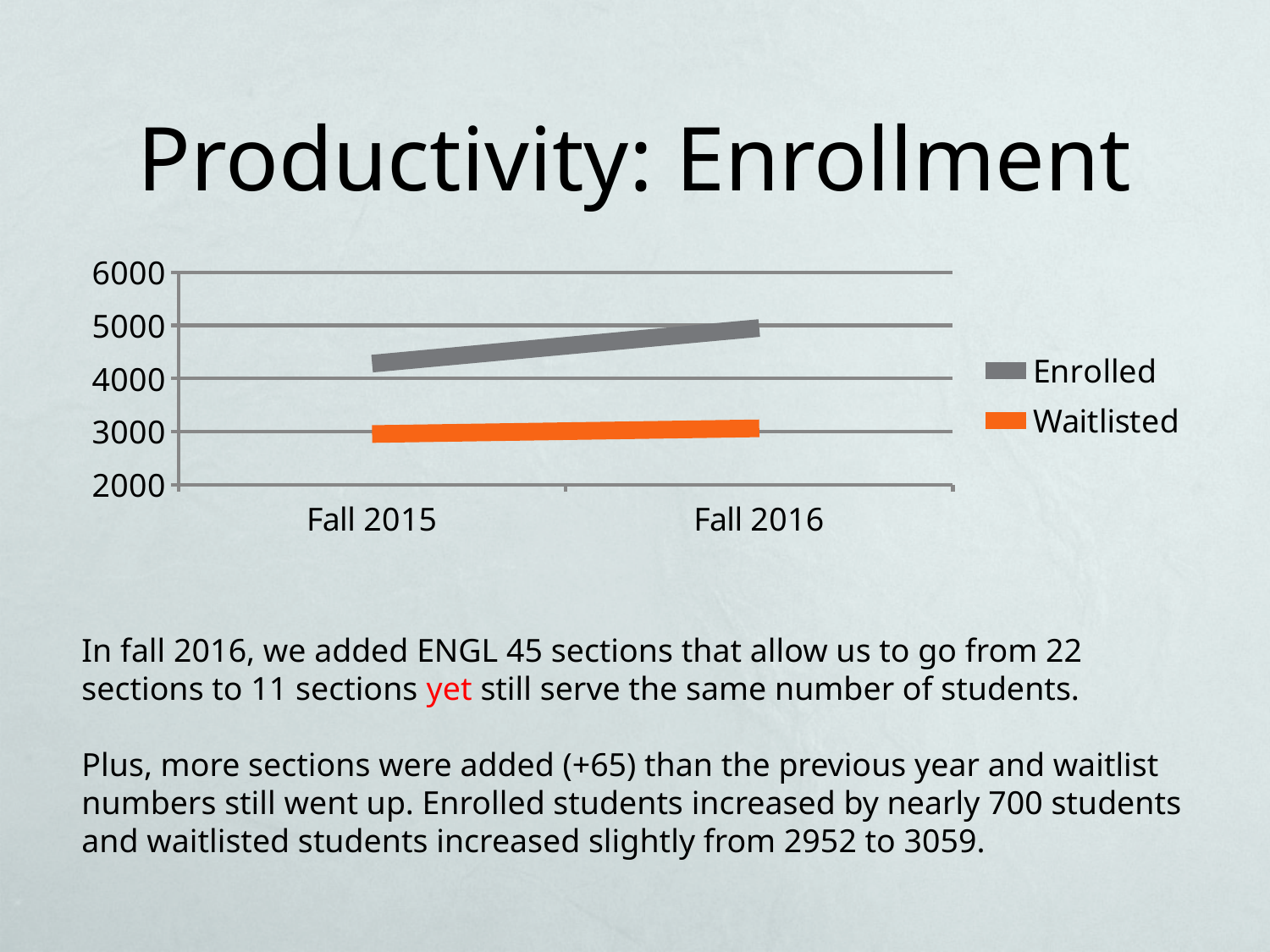
Is the Waitlisted value for Fall 2016 greater or less than 4000? less Is the Enrolled value for Fall 2015 greater or less than 4000? greater Does the Waitlisted line rise or fall from Fall 2015 to Fall 2016? rise In which period is the Enrolled value lowest? Fall 2015 Does the Enrolled line rise or fall from Fall 2015 to Fall 2016? rise How many series does the chart legend list? 2 What is the highest value shown on the chart's y axis? 6000 What kind of chart is shown on the slide? line chart In which period is the Enrolled value highest? Fall 2016 What colour is the Waitlisted line in the chart? orange How many time periods are shown on the x axis of the chart? 2 In Fall 2016, which series has the higher value, Enrolled or Waitlisted? Enrolled